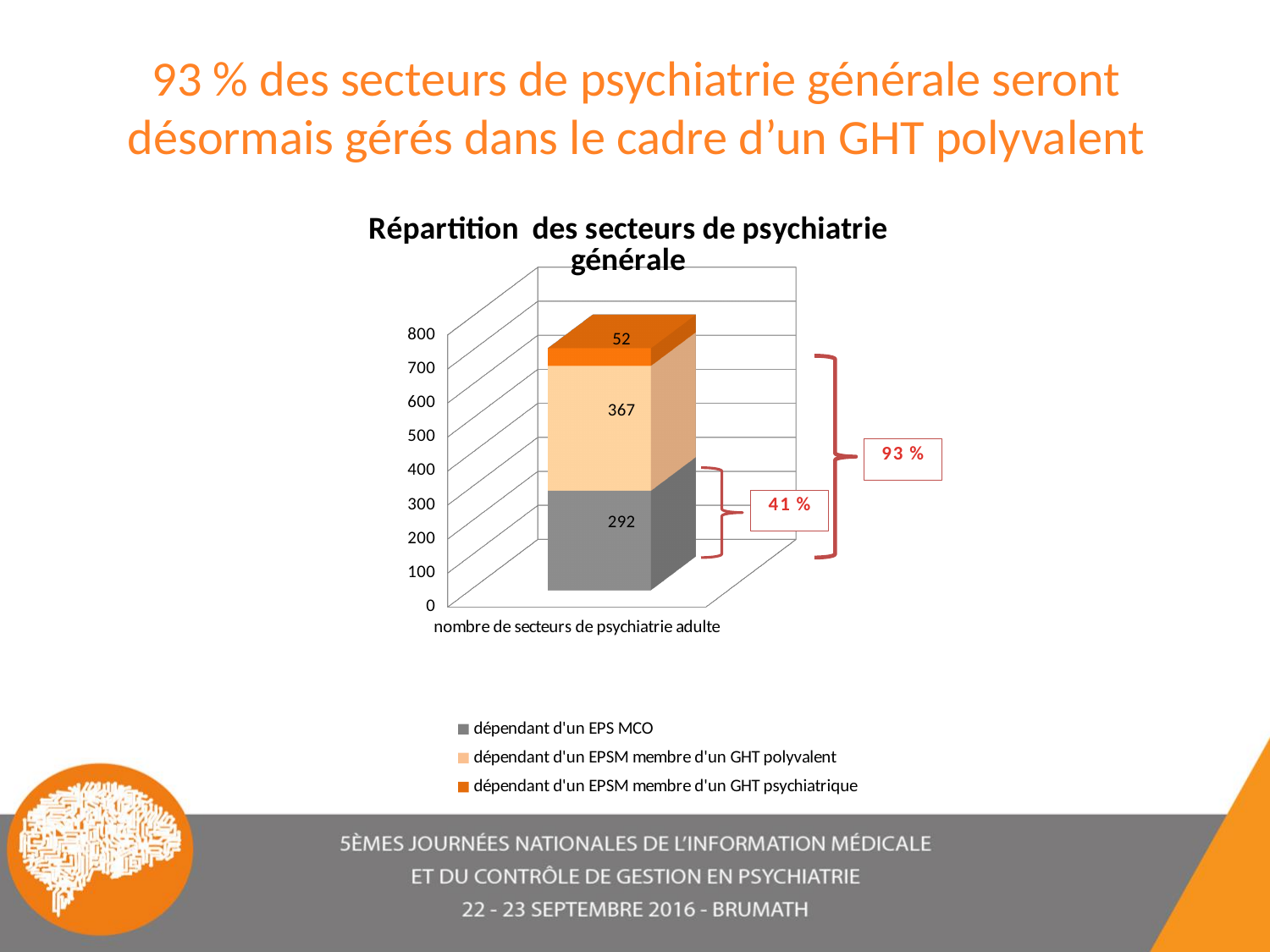
How many series does the legend list? 3 What is the total of the stacked bar for 'nombre de secteurs de psychiatrie adulte'? 711 What is the value for the series 'dépendant d'un EPSM membre d'un GHT polyvalent'? 367 Which series has the smallest value in the stacked bar? dépendant d'un EPSM membre d'un GHT psychiatrique What kind of chart is shown on the slide? stacked bar chart What is the value for the series 'dépendant d'un EPS MCO'? 292 What is the difference between the values for 'dépendant d'un EPSM membre d'un GHT polyvalent' and 'dépendant d'un EPS MCO'? 75 Which series has the largest value in the stacked bar? dépendant d'un EPSM membre d'un GHT polyvalent What is the title of the chart? Répartition des secteurs de psychiatrie générale What is the value for the series 'dépendant d'un EPSM membre d'un GHT psychiatrique'? 52 Which is larger: the value for 'dépendant d'un EPS MCO' or the value for 'dépendant d'un EPSM membre d'un GHT psychiatrique'? dépendant d'un EPS MCO